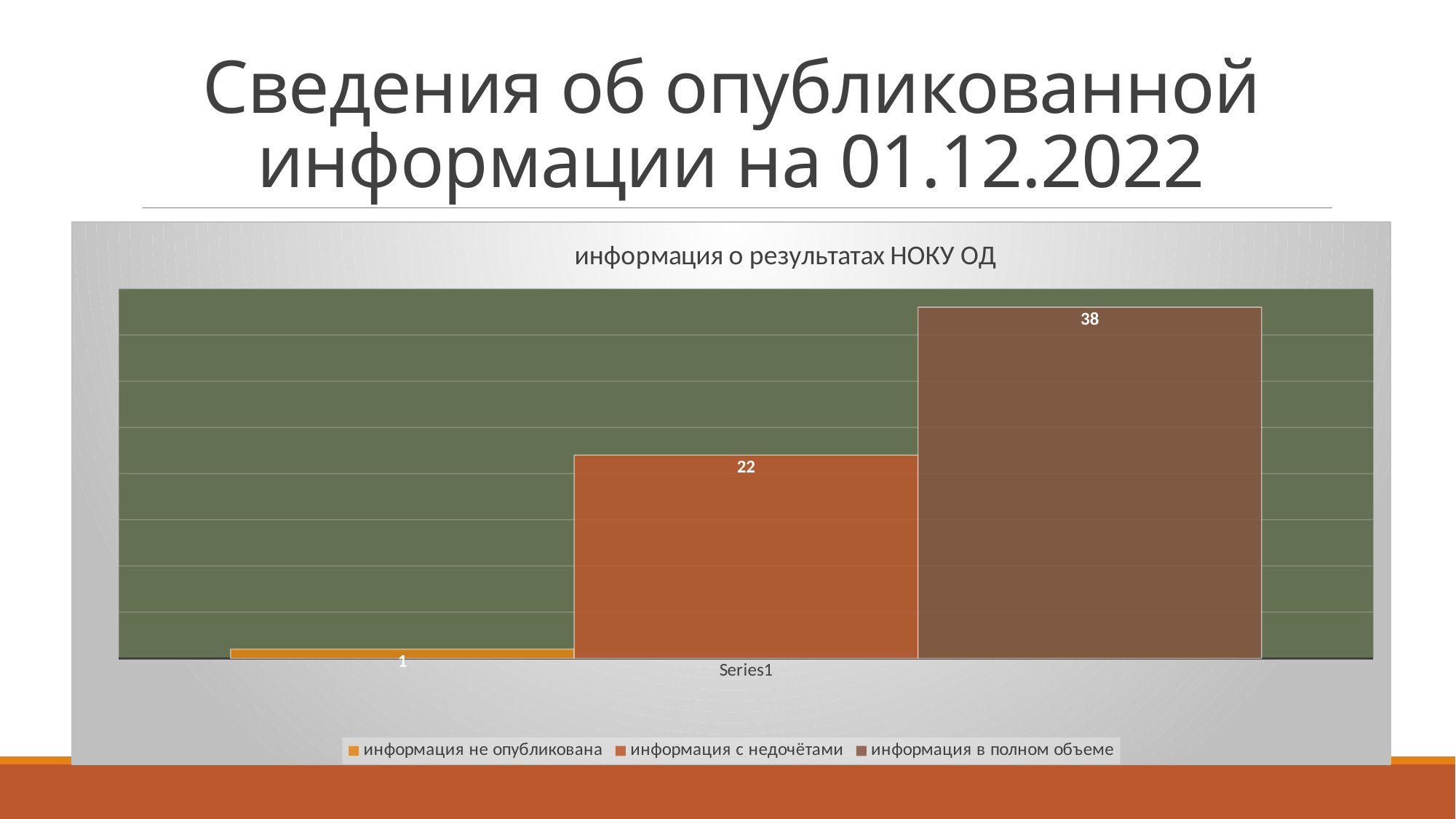
What is the category label shown on the x axis? Series1 What is the value for 'информация в полном объеме'? 38 What is the title of the chart? информация о результатах НОКУ ОД Which is larger: 'информация с недочётами' or 'информация в полном объеме'? информация в полном объеме What is the difference between 'информация с недочётами' and 'информация не опубликована'? 21 Which series has the lowest value? информация не опубликована What kind of chart is shown? bar chart What is the value for 'информация с недочётами'? 22 Which series has the highest value? информация в полном объеме What is the value for 'информация не опубликована'? 1 What is the difference between 'информация в полном объеме' and 'информация с недочётами'? 16 How many series does the legend list? 3